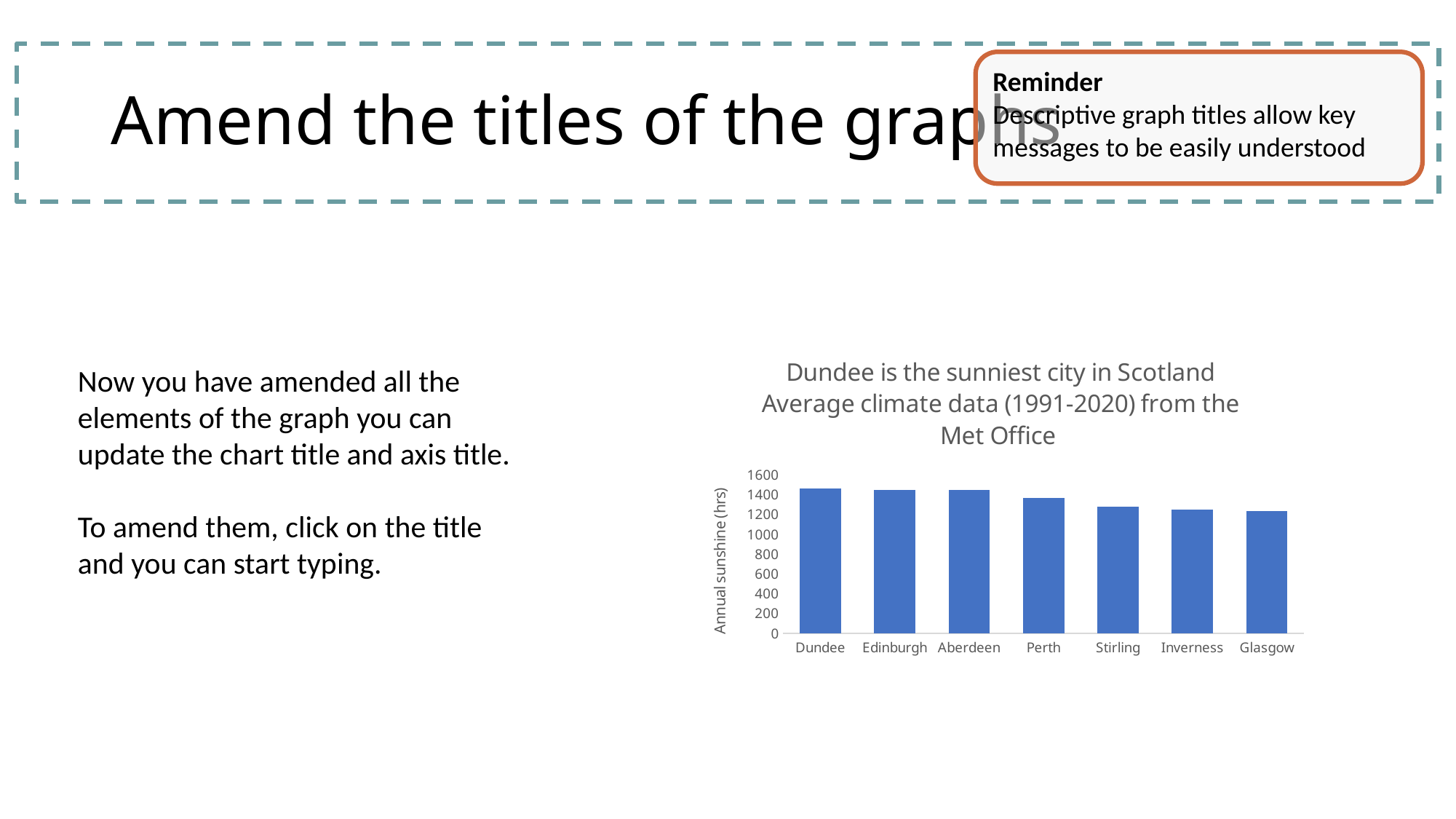
What kind of chart is shown on the slide? Bar chart Is the value for Stirling greater or less than 1400? less How many cities are shown on the x axis of the chart? 7 Is the value for Dundee greater or less than 1400? greater Is the value for Aberdeen greater or less than 1400? greater What is the label on the vertical axis of the chart? Annual sunshine (hrs) Do the values rise or fall from left to right along the x axis? Fall Which city has the highest annual sunshine in the chart? Dundee Which has the larger value, Dundee or Glasgow? Dundee Which has the larger value, Perth or Inverness? Perth